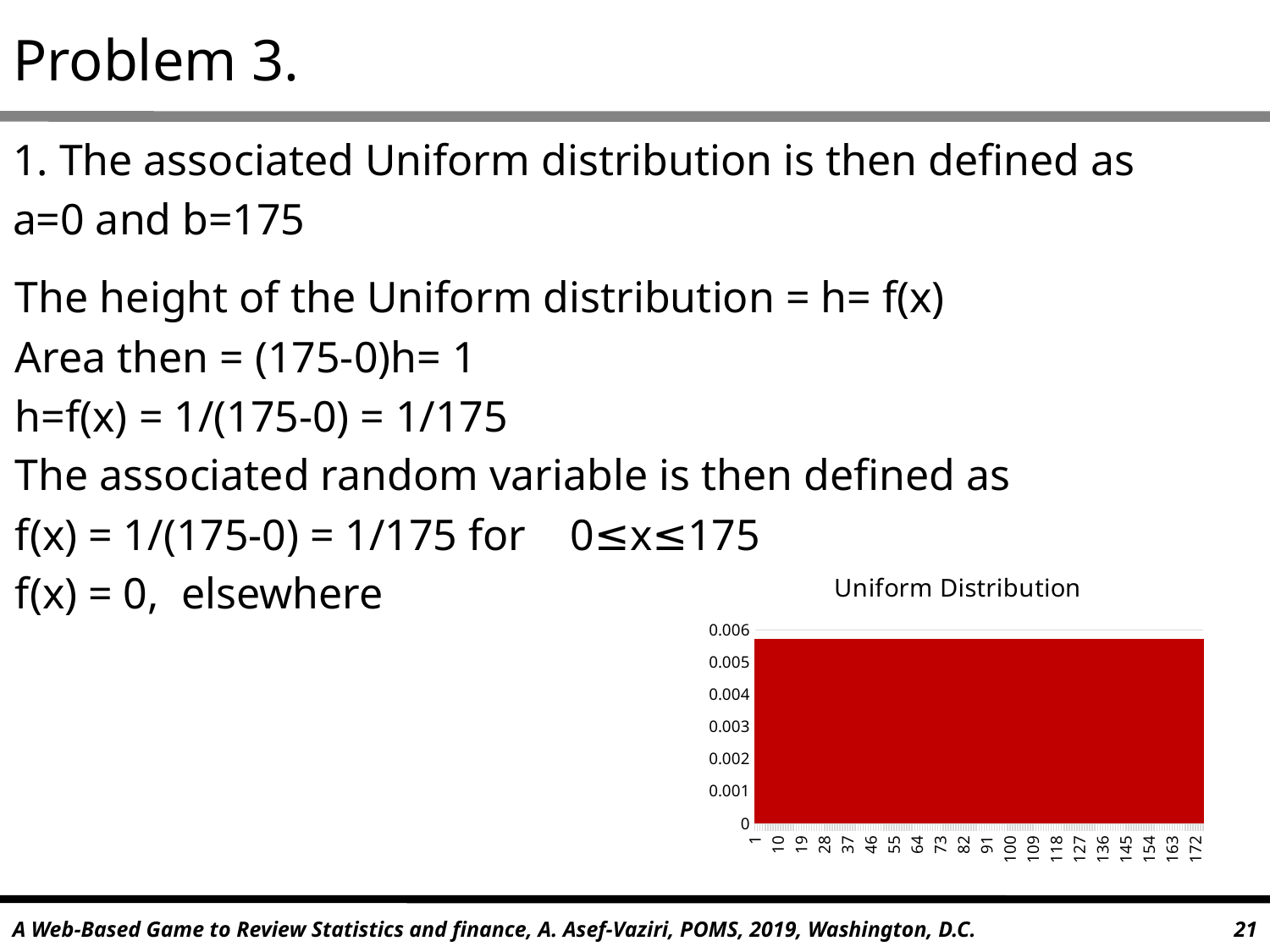
What colour are the bars in the chart? red Is the value for x=1 greater or less than 0.004? greater What is the highest tick value shown on the y axis of the chart? 0.006 Is the value for x=172 greater or less than 0.003? greater What is the title of the chart on the slide? Uniform Distribution What kind of chart is shown on the slide? area chart What is the last tick label shown on the x axis of the chart? 172 What is the first tick label shown on the x axis of the chart? 1 Is the value for x=100 greater or less than 0.005? greater Do the plotted values rise, fall, or stay flat as x increases along the x axis? stay flat